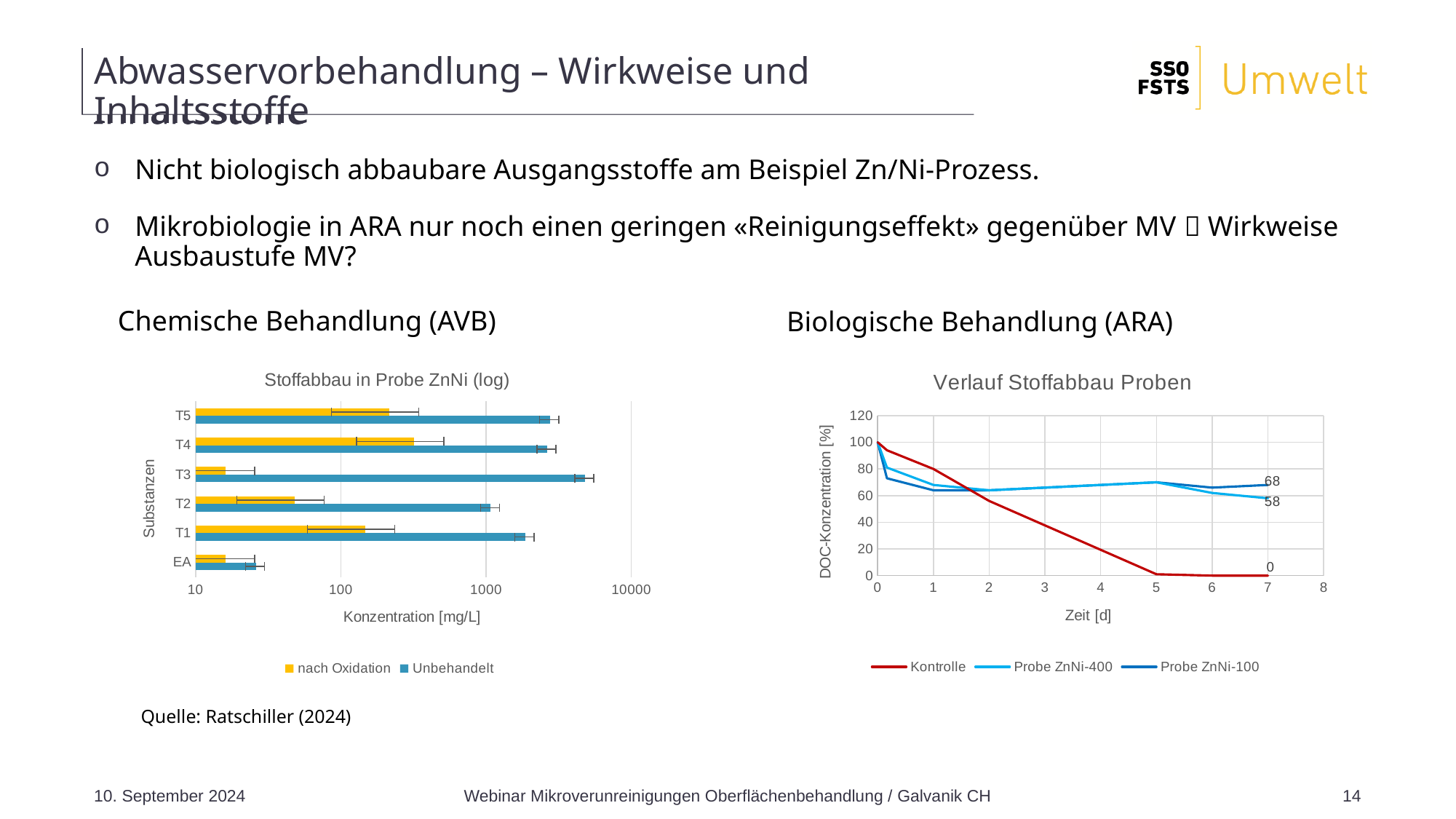
What kind of chart is the left chart titled 'Stoffabbau in Probe ZnNi (log)'? bar chart How many series does the legend of the left chart 'Stoffabbau in Probe ZnNi (log)' list? 2 How many series does the legend of the right chart 'Verlauf Stoffabbau Proben' list? 3 In the left chart 'Stoffabbau in Probe ZnNi (log)', is the Unbehandelt value for T3 greater or less than 1000? greater In the right chart 'Verlauf Stoffabbau Proben', what is the value of Kontrolle at day 7? 0 In the left chart 'Stoffabbau in Probe ZnNi (log)', how many substance categories are shown on the y axis? 6 In the right chart 'Verlauf Stoffabbau Proben', what is the DOC concentration of Probe ZnNi-100 at day 7? 68 In the right chart 'Verlauf Stoffabbau Proben', does the Kontrolle series rise or fall over time? fall What kind of chart is the right chart titled 'Verlauf Stoffabbau Proben'? line chart In the right chart 'Verlauf Stoffabbau Proben', what is the DOC concentration of Probe ZnNi-400 at day 7? 58 In the left chart 'Stoffabbau in Probe ZnNi (log)', which substance has the highest Unbehandelt concentration? T3 In the right chart 'Verlauf Stoffabbau Proben', what is the difference between Probe ZnNi-100 and Probe ZnNi-400 at day 7? 10